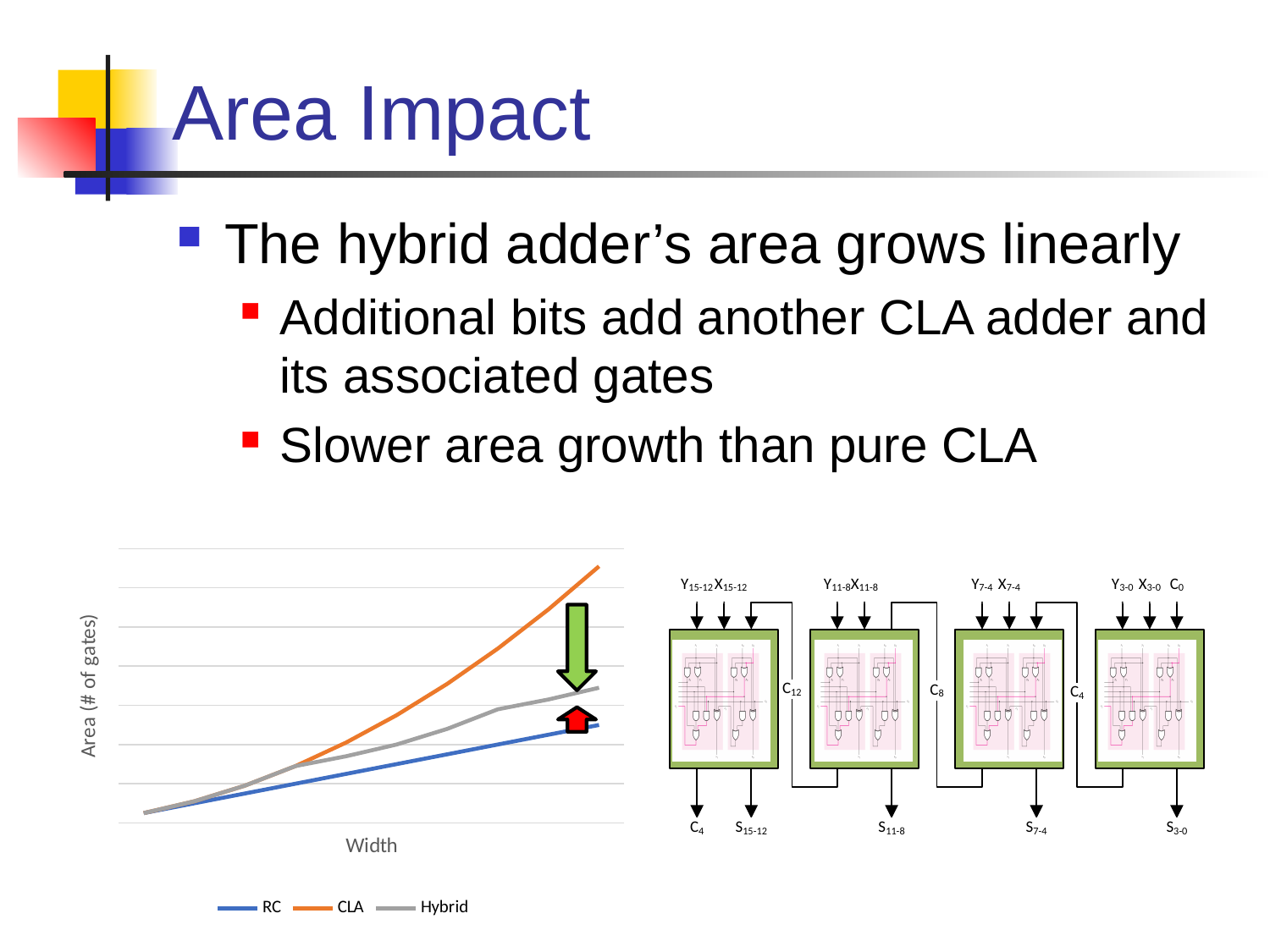
At the right end of the chart, which series has the larger area, Hybrid or RC? Hybrid What is the label of the chart's vertical axis? Area (# of gates) Does the area for the CLA series rise or fall as width increases? Rise Which series reaches the highest area at the largest width on the chart? CLA Which series has the lowest area at the largest width on the chart? RC At the right end of the chart, which series has the larger area, CLA or Hybrid? CLA What is the label of the chart's horizontal axis? Width What kind of chart is shown on the slide? Line chart Which series on the chart grows fastest as width increases? CLA How many series does the chart's legend list? 3 Does the area for the RC series rise or fall as width increases? Rise